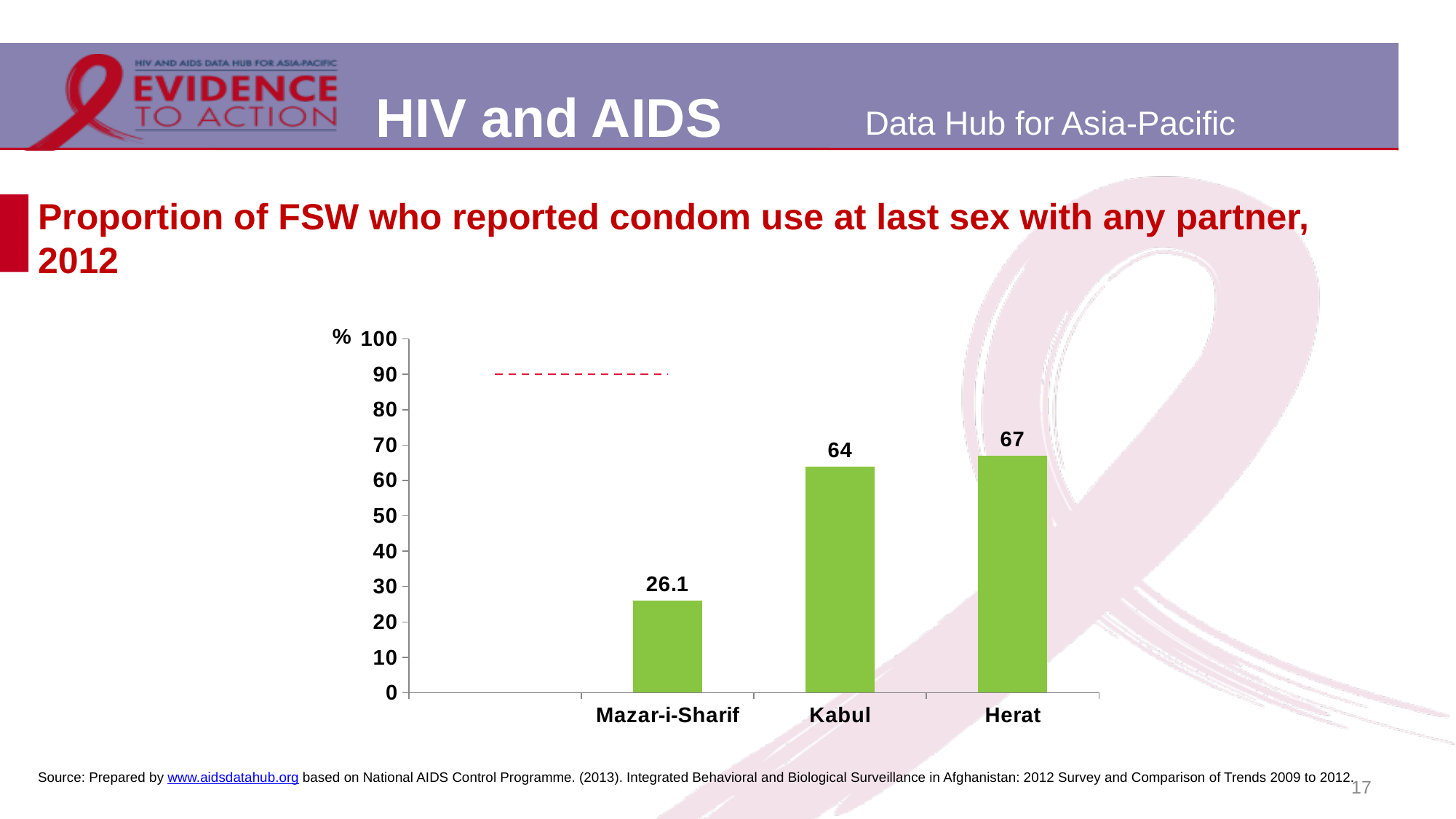
What is the value for Kabul? 64 Is the value for Mazar-i-Sharif greater or less than 30? less What is the difference between the values for Herat and Kabul? 3 How many cities are shown in the chart? 3 What is the difference between the values for Kabul and Mazar-i-Sharif? 37.9 Which city has the highest proportion of FSW reporting condom use at last sex? Herat Which is larger, the value for Kabul or the value for Mazar-i-Sharif? Kabul What unit is shown on the vertical axis of the chart? % Which city has the lowest proportion of FSW reporting condom use at last sex? Mazar-i-Sharif What is the value for Herat? 67 What kind of chart is shown on the slide? bar chart What is the value for Mazar-i-Sharif? 26.1